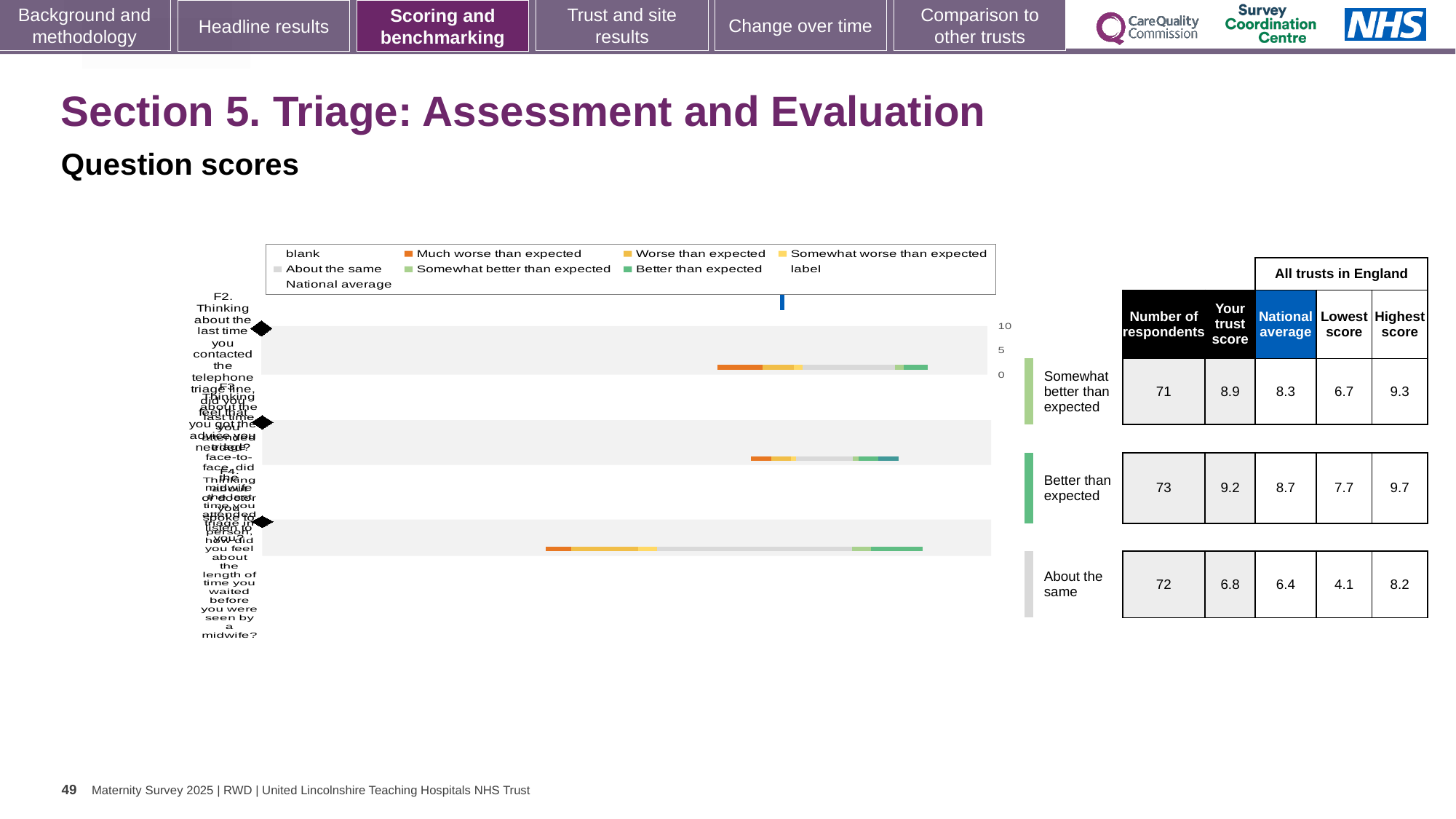
In the table beside the chart, which row has the lowest value in the 'Lowest score' column? About the same In the table beside the chart, what is the trust score for the row labelled 'About the same'? 6.8 In the chart legend, what colour is used for 'Much worse than expected'? orange In the table beside the chart, how much higher is the trust score than the national average for the row labelled 'Better than expected'? 0.5 In the table beside the chart, what is the national average for the row labelled 'Somewhat better than expected'? 8.3 In the table beside the chart, which row has the highest 'Your trust score'? Better than expected In the table beside the chart, what is the number of respondents for the row labelled 'Better than expected'? 73 What kind of chart is shown on the slide? bar chart How many question rows (F2, F3, F4) are plotted in the chart? 3 In the table beside the chart, what is the highest score for the row labelled 'About the same'? 8.2 In the table beside the chart, which row has the larger 'Highest score': 'Better than expected' or 'Somewhat better than expected'? Better than expected